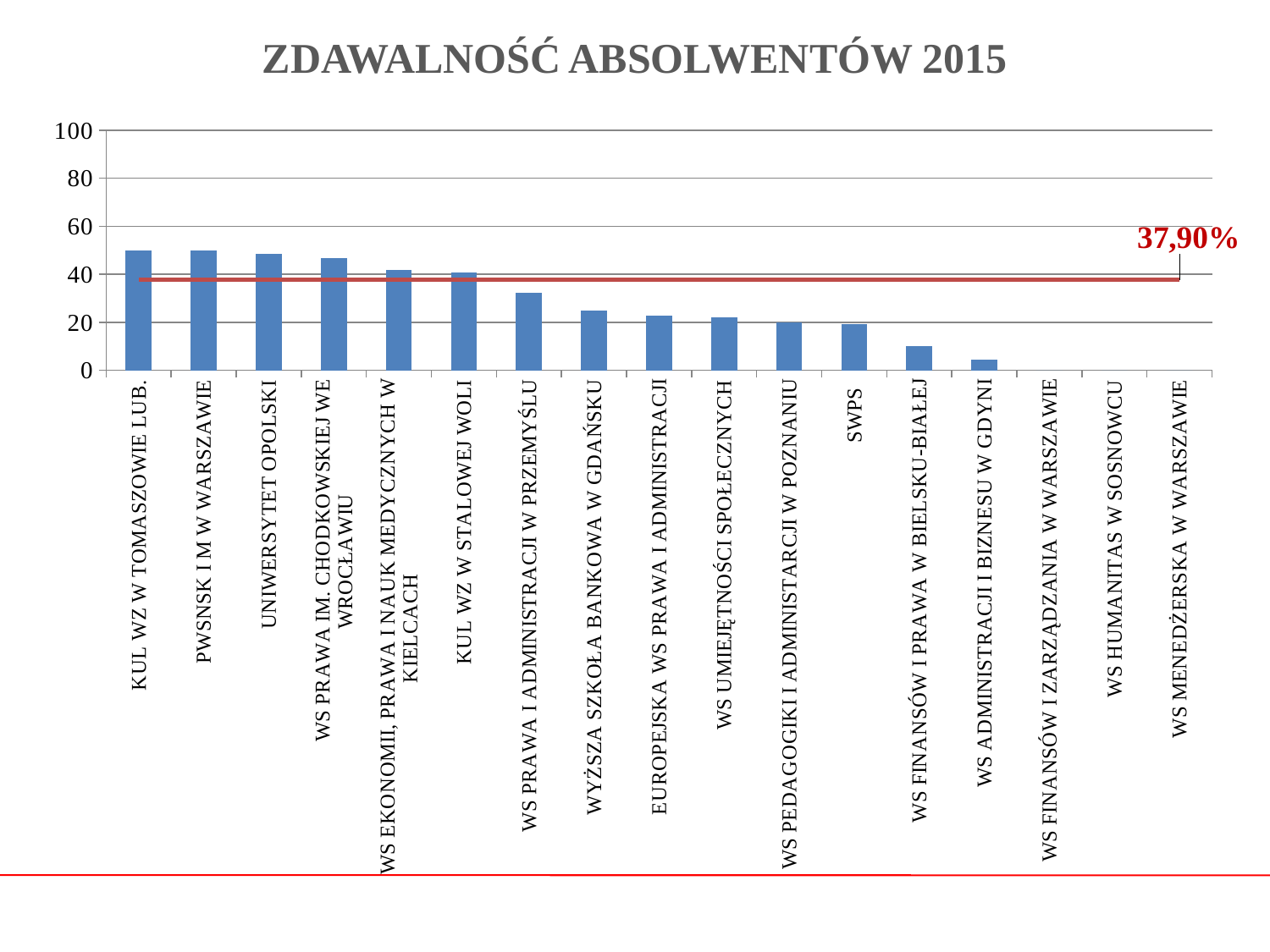
Which has the larger value, UNIWERSYTET OPOLSKI or WYŻSZA SZKOŁA BANKOWA W GDAŃSKU? UNIWERSYTET OPOLSKI Which has the larger value, WS ADMINISTRACJI I BIZNESU W GDYNI or WS PRAWA I ADMINISTRACJI W PRZEMYŚLU? WS PRAWA I ADMINISTRACJI W PRZEMYŚLU What is the title of the chart? ZDAWALNOŚĆ ABSOLWENTÓW 2015 What kind of chart is shown on the slide? bar chart Is the value for WS FINANSÓW I PRAWA W BIELSKU-BIAŁEJ greater or less than 20? less What value is labelled on the red horizontal line across the chart? 37,90% Is the value for WS PRAWA I ADMINISTRACJI W PRZEMYŚLU greater or less than 40? less Do the bar values generally rise or fall from left to right along the x axis? fall Is the value for UNIWERSYTET OPOLSKI greater or less than 40? greater How many categories (institutions) are shown on the x axis? 17